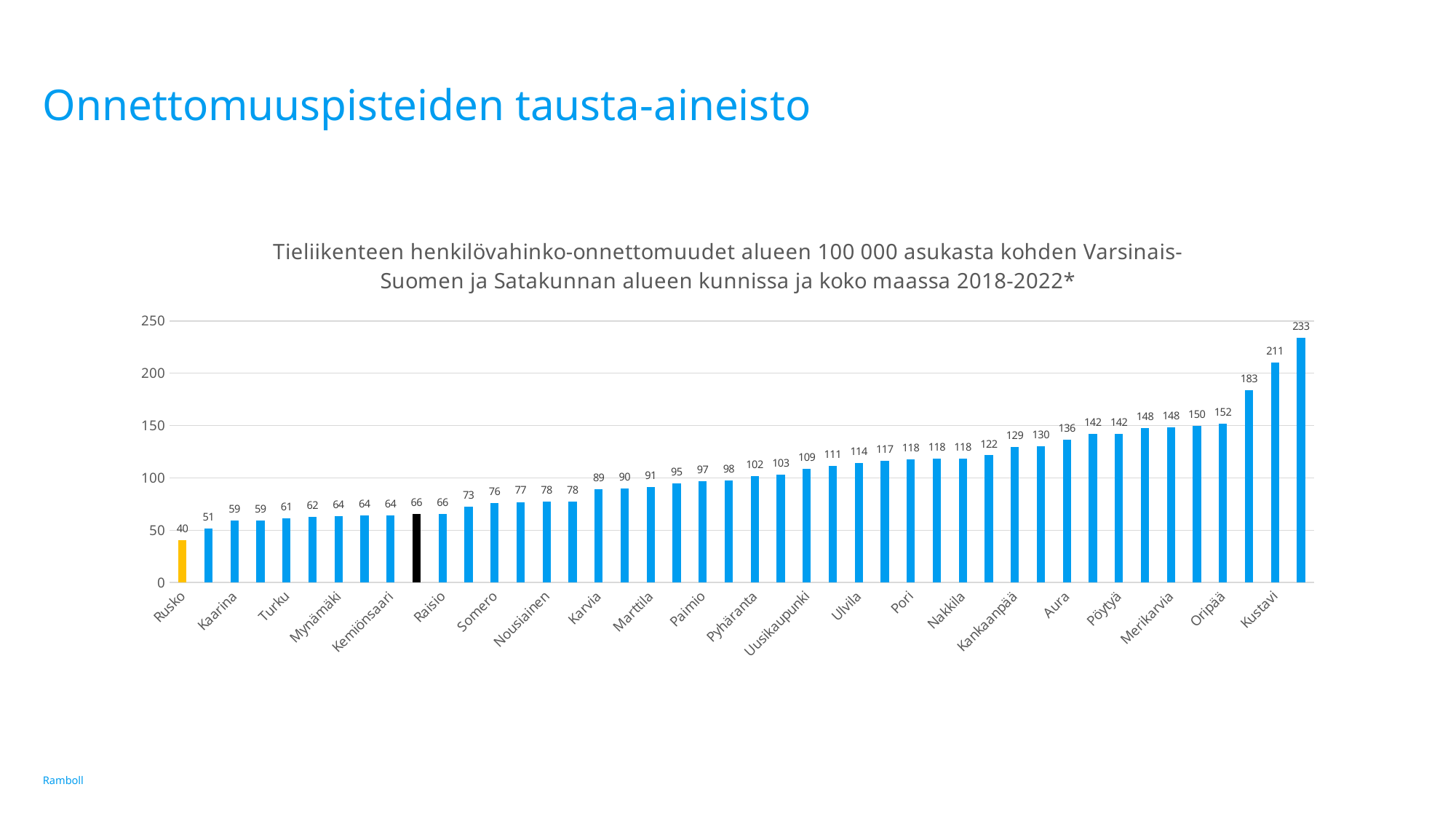
What colour is the bar for Rusko? Yellow Which is larger, the value for Kustavi or the value for Rusko? Kustavi What is the value for Rusko? 40 Which municipality has the lowest value in the chart? Rusko Is the value for Pori greater or less than 100? greater What is the highest value shown in the chart? 233 What is the value for Kustavi? 211 What kind of chart is shown on the slide? Bar chart What is the difference between the value for Kustavi and the value for Rusko? 171 Is the value for Kaarina greater or less than 100? less How many bars are plotted in the chart? 44 Do the values rise or fall from left to right along the x axis? Rise